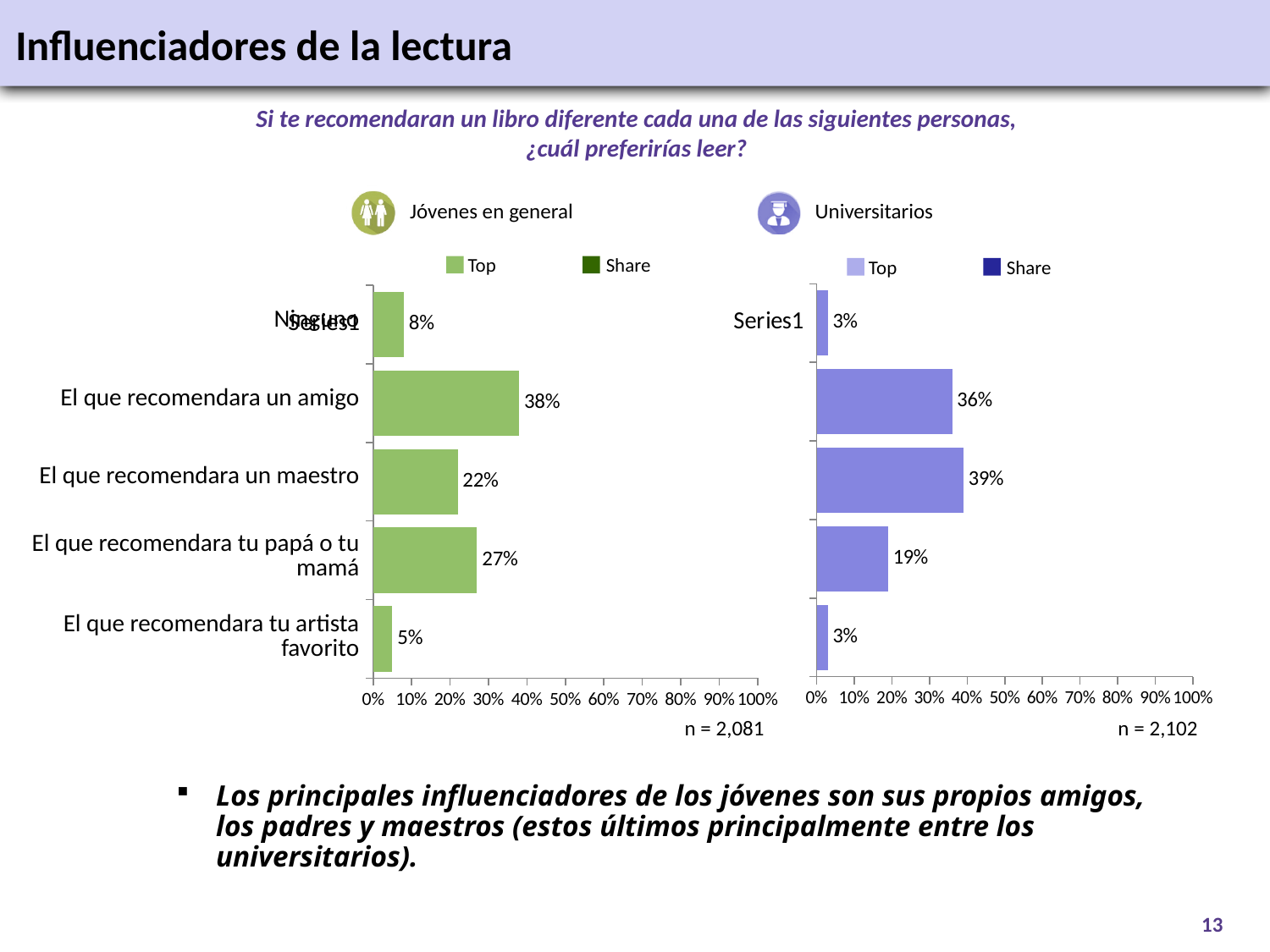
In the Jóvenes en general chart, which category has the lowest value? El que recomendara tu artista favorito In the Universitarios chart, what is the value for 'El que recomendara tu artista favorito'? 3% How many entries does the legend of the Universitarios chart list? 2 In the Universitarios chart, what is the value for 'El que recomendara un maestro'? 39% What kind of chart is the Jóvenes en general chart? Bar chart In the Jóvenes en general chart, what is the value for 'El que recomendara tu papá o tu mamá'? 27% For 'El que recomendara un maestro', which group has the larger value, Jóvenes en general or Universitarios? Universitarios In the Jóvenes en general chart, which category has the highest value? El que recomendara un amigo In the Jóvenes en general chart, what is the value for 'El que recomendara un amigo'? 38% In the Universitarios chart, which category has the highest value? El que recomendara un maestro In the Universitarios chart, what is the difference between 'El que recomendara un maestro' and 'El que recomendara tu papá o tu mamá'? 20% In the Jóvenes en general chart, what is the difference between 'El que recomendara un amigo' and 'El que recomendara un maestro'? 16%